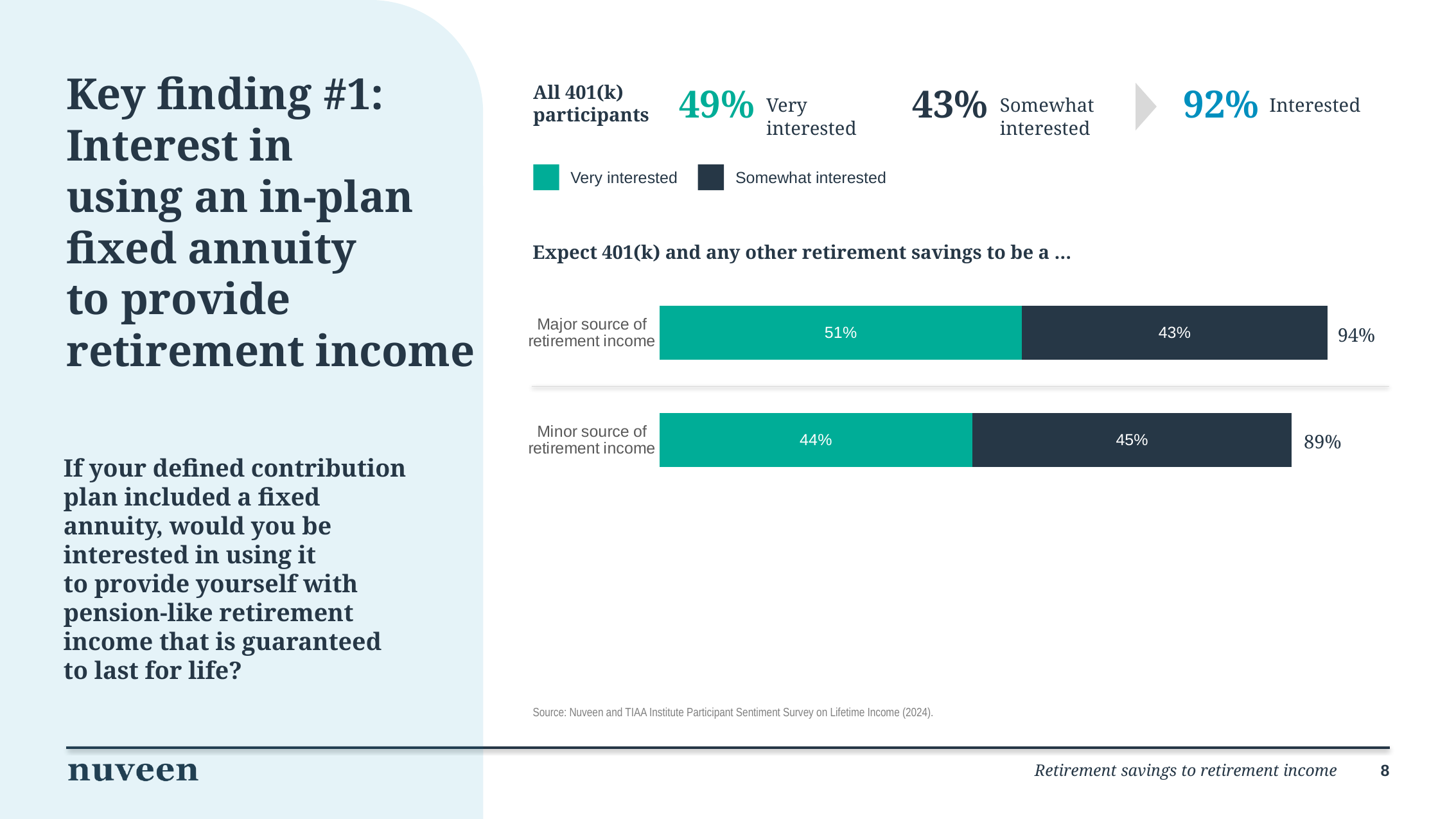
What percentage of those who expect retirement savings to be a major source of retirement income are very interested? 51% What is the somewhat interested value for the major source of retirement income category? 43% How many series does the legend list? 2 What is the total interested share for the major source of retirement income bar? 94% Which category has the higher very interested share, major source or minor source of retirement income? Major source of retirement income What is the very interested value for the minor source of retirement income category? 44% What is the difference between the very interested shares for major source and minor source of retirement income? 7% What percentage of those who expect retirement savings to be a minor source of retirement income are somewhat interested? 45% How many categories are shown in the bar chart? 2 What is the total interested share for the minor source of retirement income bar? 89% What is the difference between the total interested shares of the major source and minor source bars? 5% What type of chart is used to show the expected source of retirement income data? Stacked bar chart